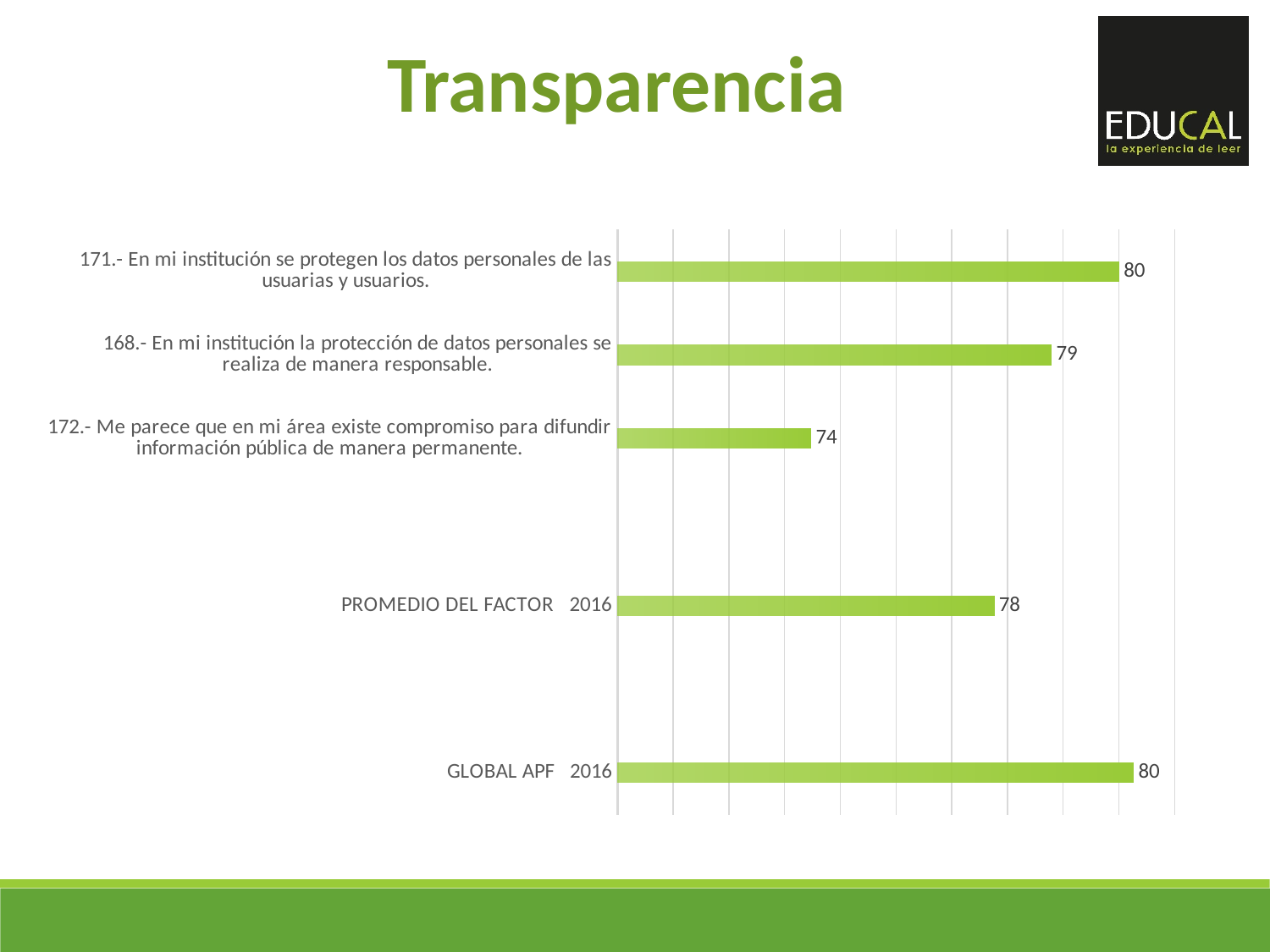
What type of chart is shown on the slide? Bar chart What is the value of GLOBAL APF 2016? 80 How many bars are plotted in the chart? 5 Which is larger, the value for item 168 or the value for PROMEDIO DEL FACTOR 2016? Item 168 What value is shown for item 171 ("En mi institución se protegen los datos personales de las usuarias y usuarios")? 80 What value is shown for item 172 ("Me parece que en mi área existe compromiso para difundir información pública de manera permanente")? 74 Which category has the lowest value in the chart? 172.- Me parece que en mi área existe compromiso para difundir información pública de manera permanente. What is the difference between GLOBAL APF 2016 and PROMEDIO DEL FACTOR 2016? 2 What is the difference between the value for item 171 and the value for item 172? 6 What is the title of the slide containing the chart? Transparencia What value is shown for item 168 ("En mi institución la protección de datos personales se realiza de manera responsable")? 79 What is the value of PROMEDIO DEL FACTOR 2016? 78